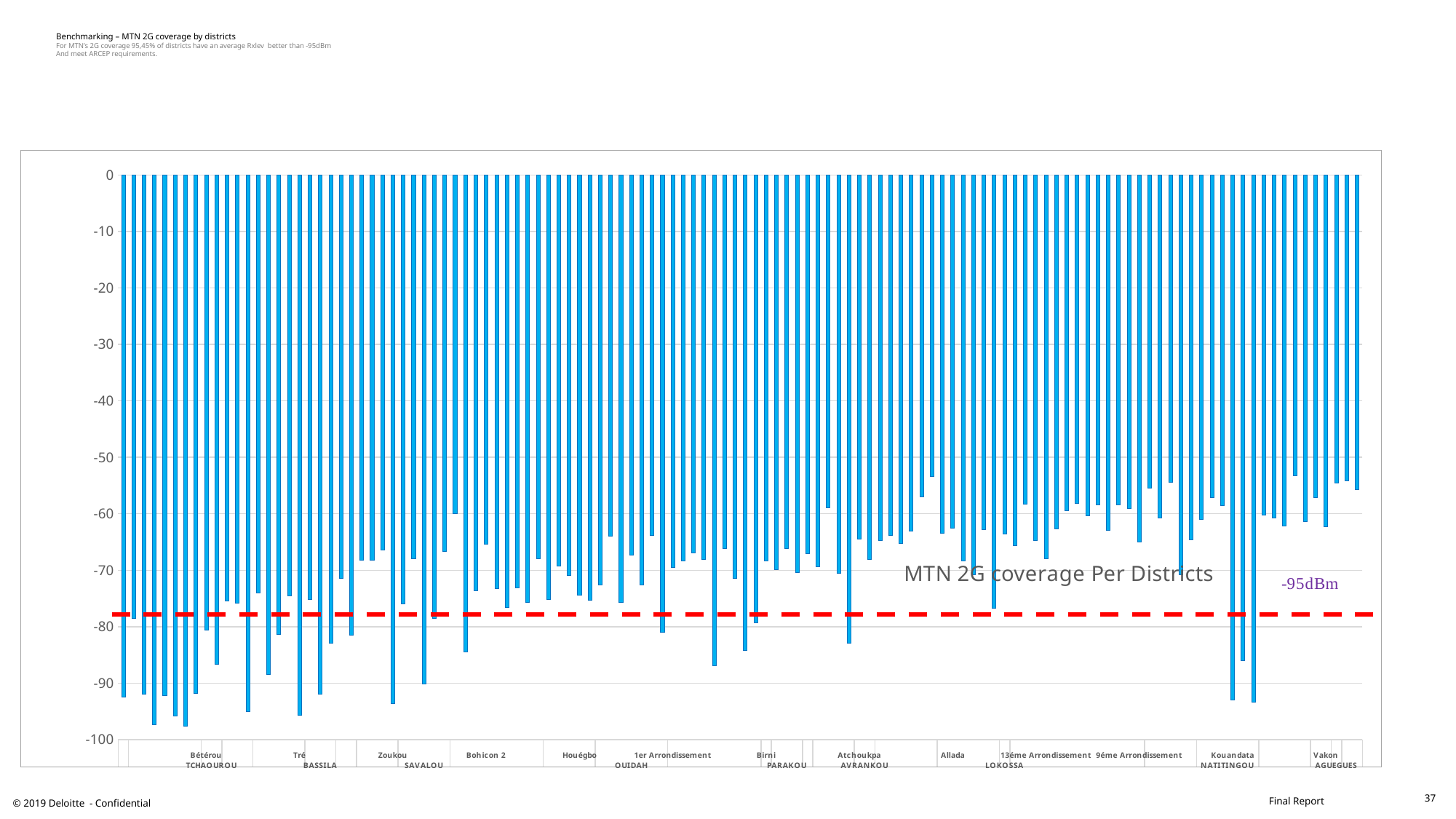
What label is printed next to the red dashed line on the chart? -95dBm What is the title printed on the chart? MTN 2G coverage Per Districts Do the bar values generally rise or fall (move closer to 0 or further from 0) from the left of the chart to the right? rise What kind of chart is shown on the slide? bar chart